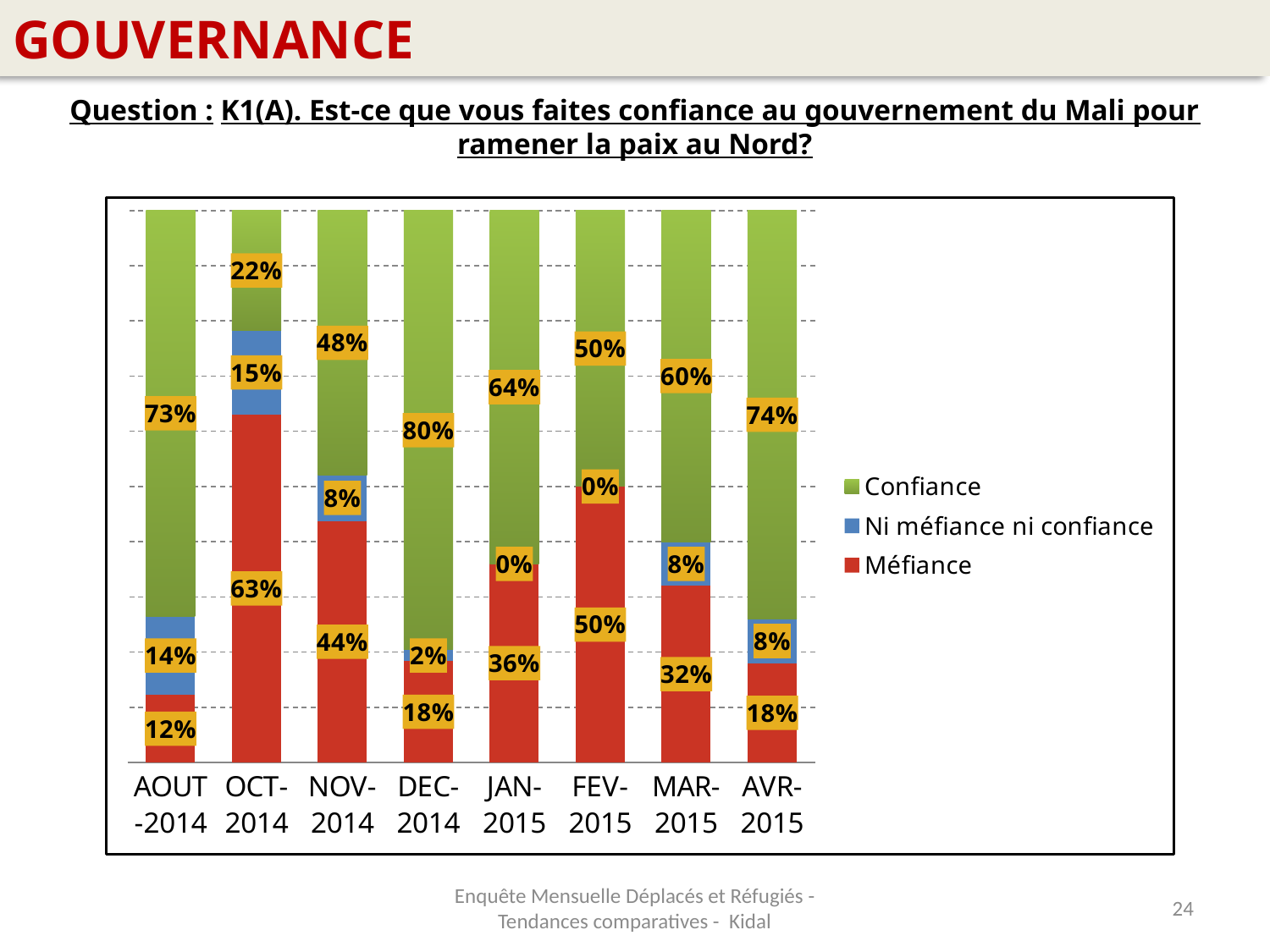
What is the Méfiance value for OCT-2014? 63% What is the Ni méfiance ni confiance value for AOUT-2014? 14% Which month has the lowest Confiance value? OCT-2014 How many series does the legend list? 3 What is the Confiance value for DEC-2014? 80% What is the Méfiance value for FEV-2015? 50% Which month has the highest Confiance value? DEC-2014 Which is larger, the Méfiance value for NOV-2014 or for JAN-2015? NOV-2014 What kind of chart is shown on the slide? Stacked bar chart What is the difference between the Confiance values for AVR-2015 and MAR-2015? 14% Which colour represents the Méfiance series? Red How many months are shown on the x axis? 8